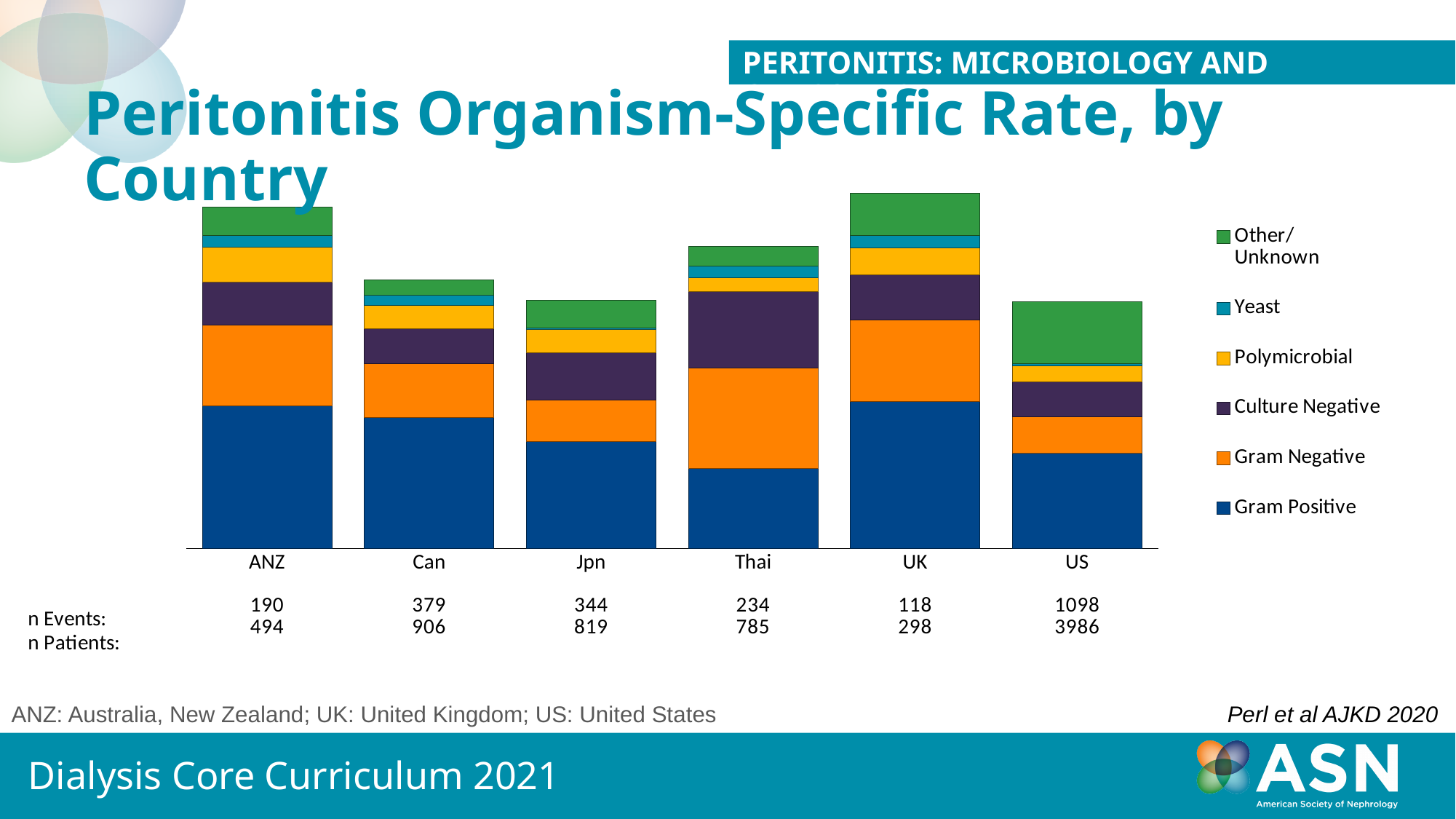
What is the difference between the n Events for the US and the n Events for ANZ? 908 Which series is listed at the top of the chart's legend? Other/Unknown Which has the larger Gram Positive segment, UK or Thai? UK Which has the larger Gram Negative segment, Thai or Jpn? Thai How many series does the chart's legend list? 6 Which country has the tallest stacked bar overall? UK How many countries or regions are shown on the x axis of the chart? 6 Which has the larger Other/Unknown segment, US or Can? US What is the number of patients (n Patients) shown for Can? 906 What kind of chart is shown on the slide? Stacked bar chart What is the number of events (n Events) shown for the US? 1098